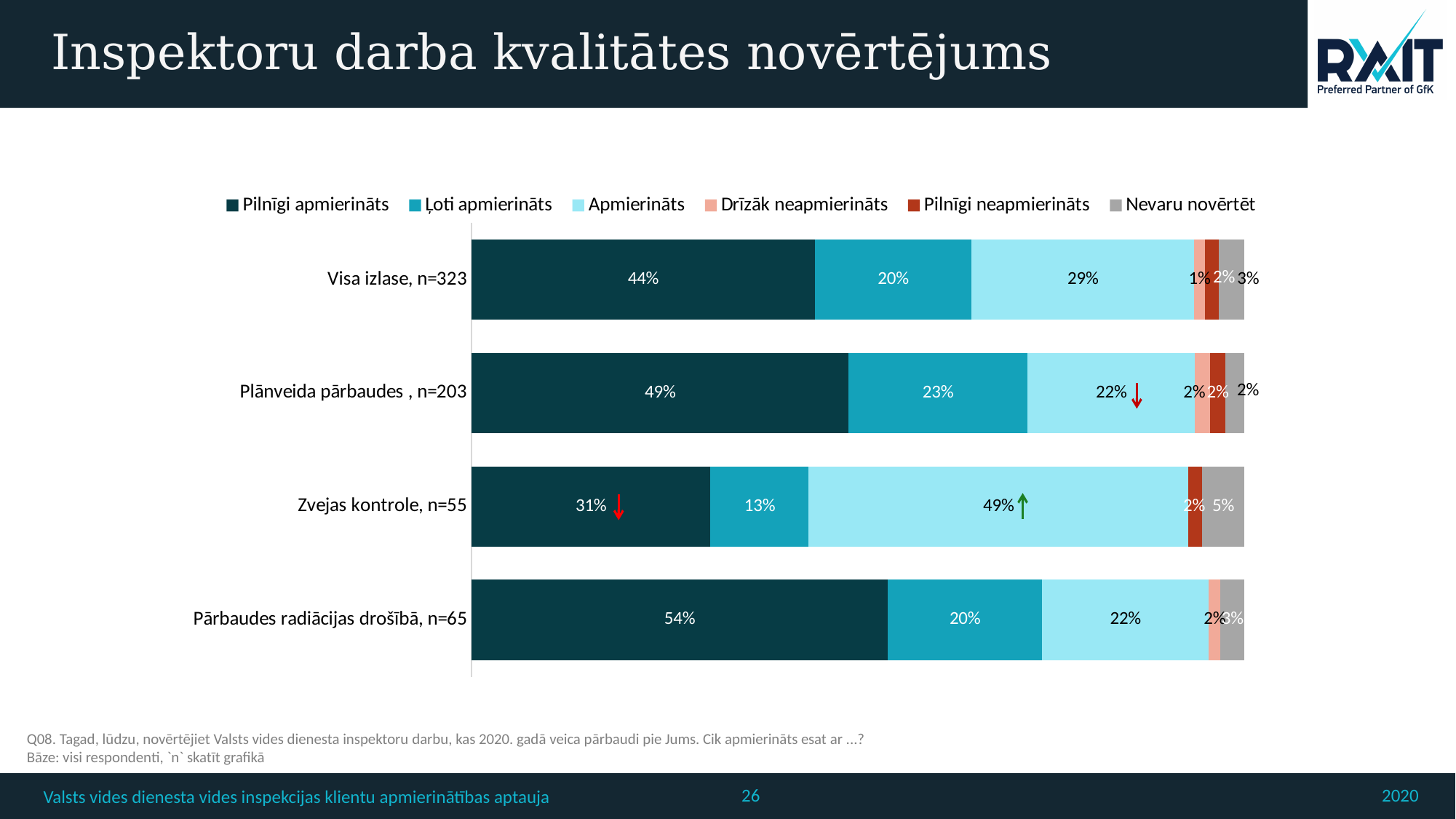
Which category has the highest 'Pilnīgi apmierināts' value? Pārbaudes radiācijas drošībā, n=65 What kind of chart is shown on the slide? Stacked bar chart What is the value of 'Nevaru novērtēt' for 'Zvejas kontrole, n=55'? 5% What is the difference between the 'Pilnīgi apmierināts' values for 'Pārbaudes radiācijas drošībā, n=65' and 'Zvejas kontrole, n=55'? 23% How many categories (bars) are shown in the chart? 4 How many series does the legend list? 6 What is the value of 'Pilnīgi apmierināts' for 'Visa izlase, n=323'? 44% Which is larger: the 'Apmierināts' value for 'Visa izlase, n=323' or for 'Plānveida pārbaudes , n=203'? Visa izlase, n=323 What is the title of the slide containing the chart? Inspektoru darba kvalitātes novērtējums Which category has the lowest 'Ļoti apmierināts' value? Zvejas kontrole, n=55 What is the value of 'Ļoti apmierināts' for 'Plānveida pārbaudes , n=203'? 23% What is the value of 'Apmierināts' for 'Zvejas kontrole, n=55'? 49%